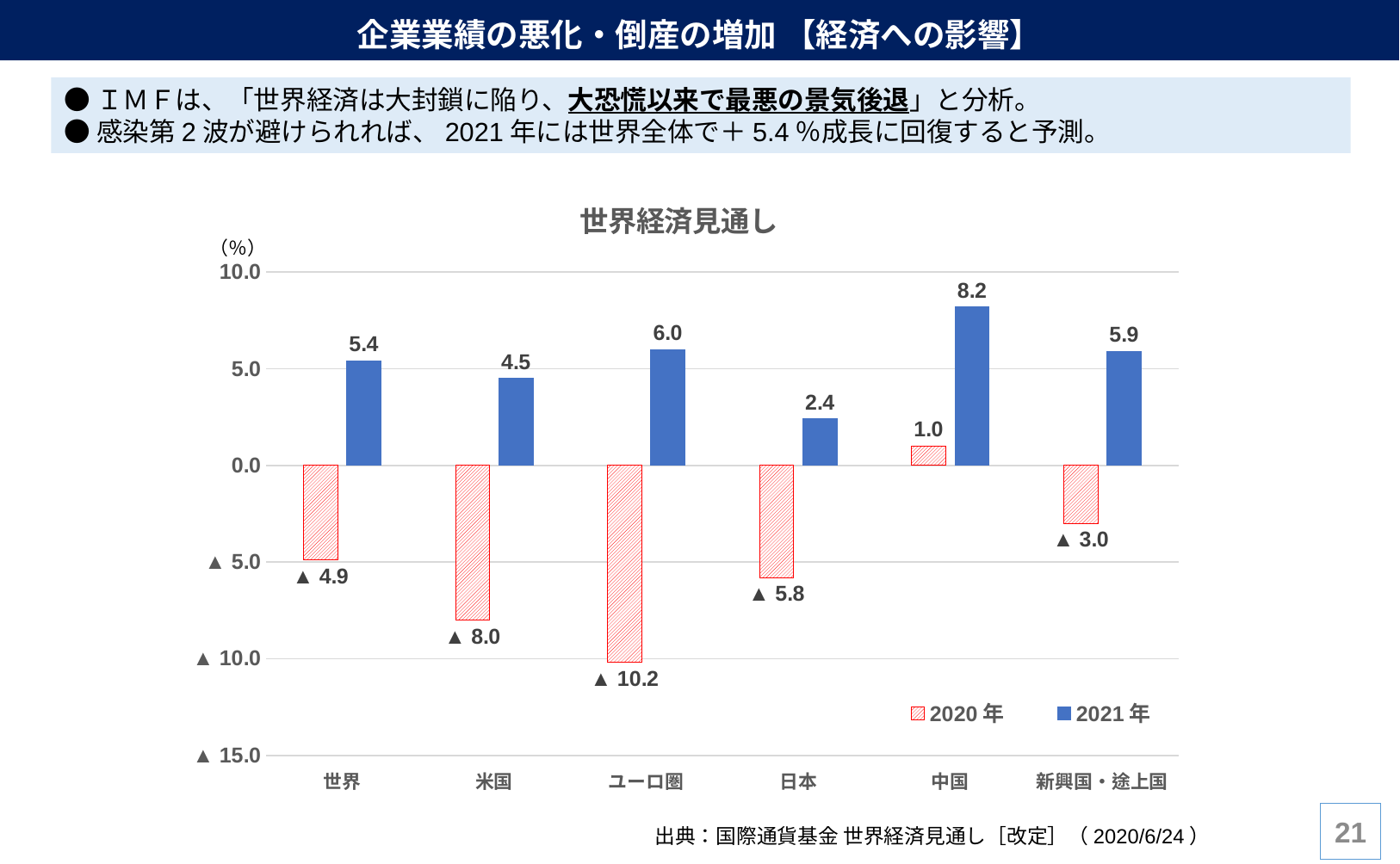
What kind of chart is the 世界経済見通し chart? bar chart How many categories are shown on the x axis of the 世界経済見通し chart? 6 What is the 2021年 value for 中国 in the 世界経済見通し chart? 8.2 What is the 2020年 value for 世界 in the 世界経済見通し chart? ▲ 4.9 Which category has the lowest 2021年 value in the 世界経済見通し chart? 日本 Which series in the 世界経済見通し chart is drawn with red hatched bars? 2020年 Which is larger in the 世界経済見通し chart: the 2021年 value for 米国 or the 2021年 value for ユーロ圏? ユーロ圏 What is the 2020年 value for ユーロ圏 in the 世界経済見通し chart? ▲ 10.2 How many series does the legend of the 世界経済見通し chart list? 2 Which category has the highest 2021年 value in the 世界経済見通し chart? 中国 What is the difference between the 2021年 and 2020年 values for 中国 in the 世界経済見通し chart? 7.2 Which category has the lowest 2020年 value in the 世界経済見通し chart? ユーロ圏